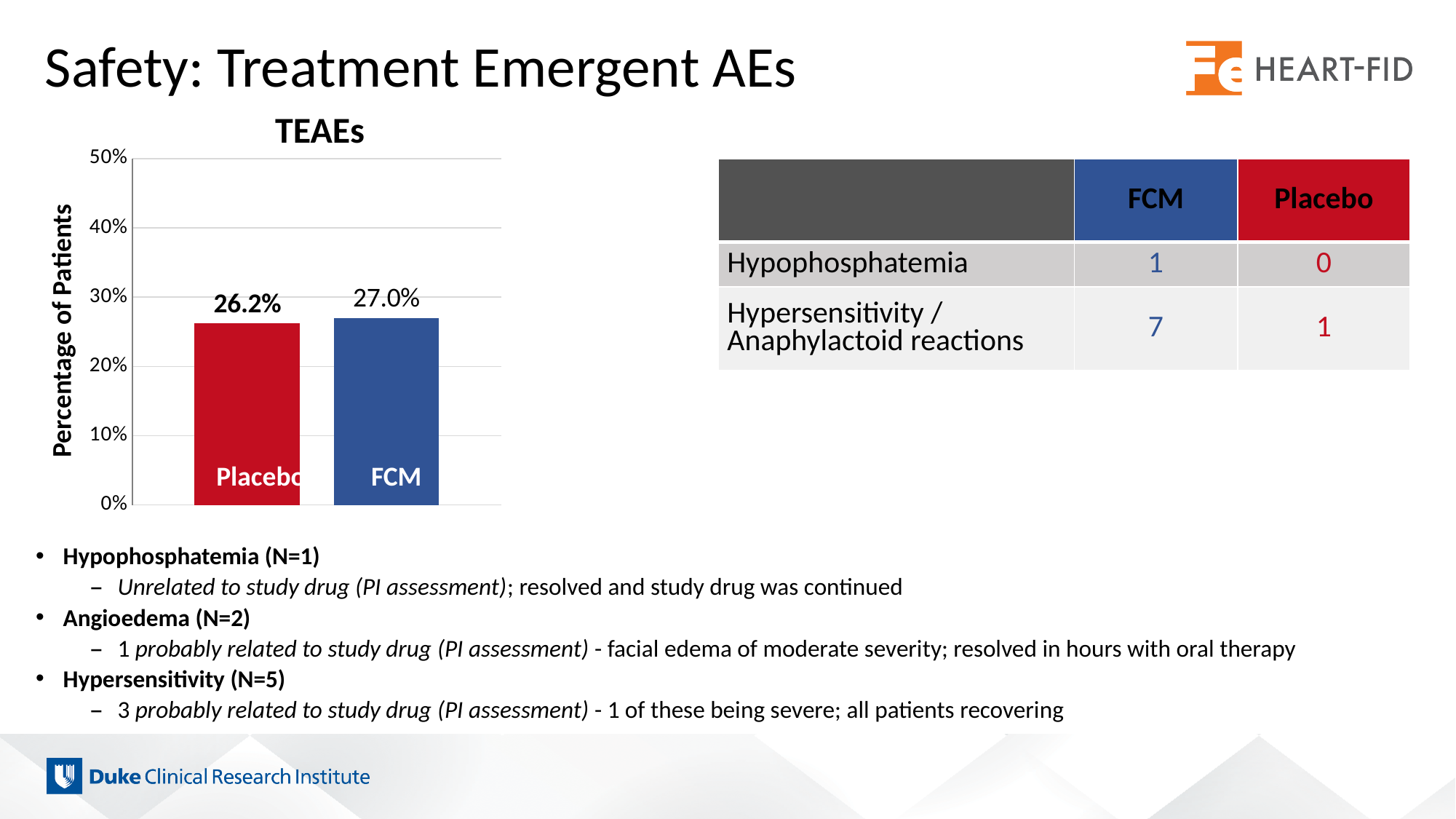
Is the value for FCM greater or less than 30%? less Is the value for Placebo greater or less than 20%? greater How many bars are shown in the TEAEs chart? 2 What is the maximum value shown on the y-axis of the TEAEs chart? 50% What is the y-axis label of the TEAEs chart? Percentage of Patients What is the title of the chart? TEAEs What is the value for Placebo in the TEAEs chart? 26.2% What kind of chart is the TEAEs chart? bar chart What is the value for FCM in the TEAEs chart? 27.0% Which group has the higher percentage of patients with TEAEs? FCM What is the difference between the FCM and Placebo values in the TEAEs chart? 0.8% Which group has the lower percentage of patients with TEAEs? Placebo